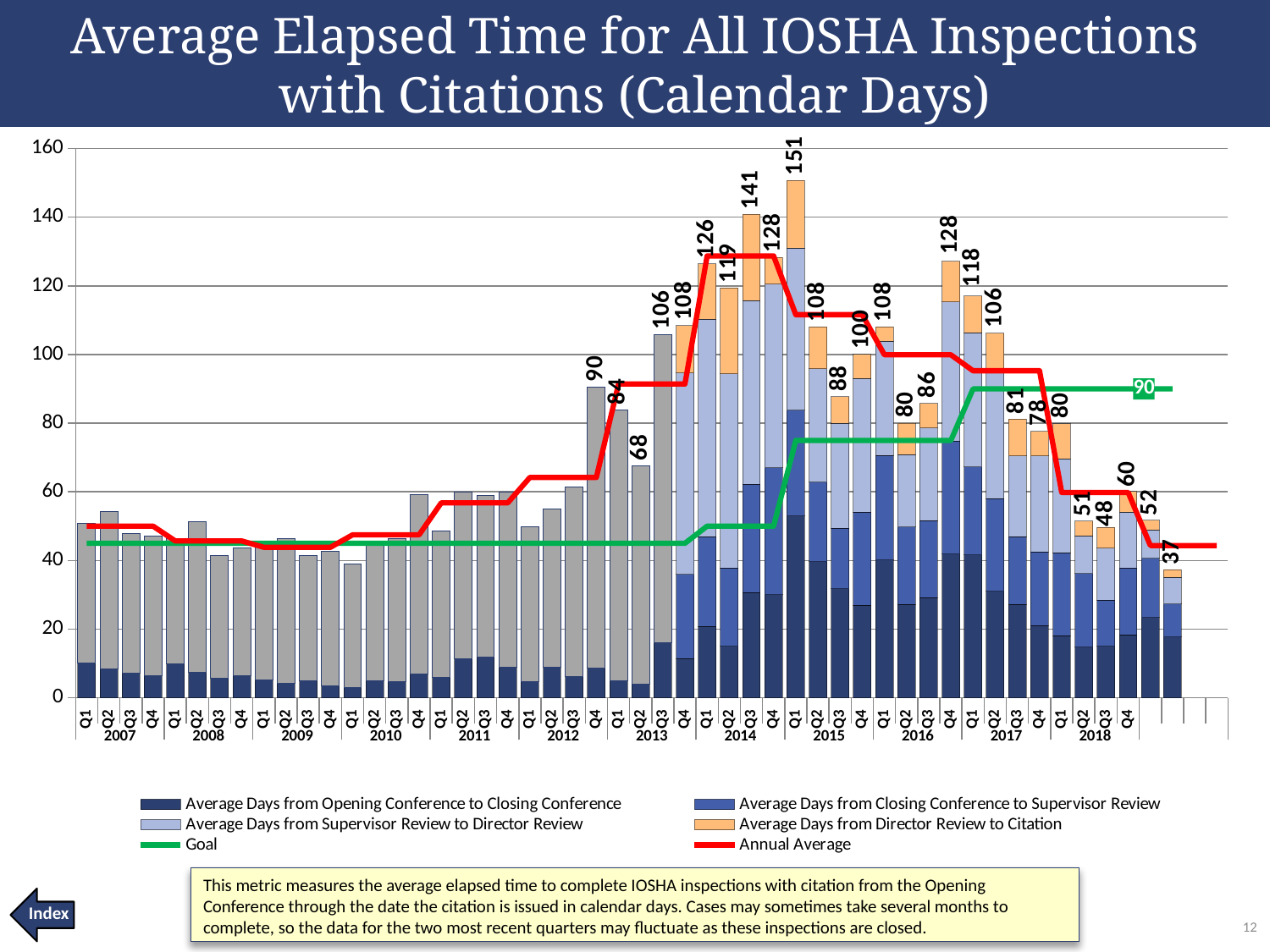
Which quarter has the highest labeled total on the chart? Q1 2015 What kind of chart is used to show the quarterly elapsed time? bar chart Is the total bar height for Q1 2009 greater or less than 60? less What is the total average elapsed time labeled for Q1 2015? 151 What is the difference between the labeled values for Q4 2018 and Q3 2018? 12 What value is labeled on the Goal line at the right end of the chart? 90 Do the labeled totals rise or fall from Q2 2013 to Q1 2014? rise What is the difference between the labeled values for Q1 2015 and Q3 2014? 10 What is the labeled value for Q2 2018? 51 Which is larger, the labeled value for Q4 2016 or for Q1 2017? Q4 2016 How many entries does the legend list? 6 What is the labeled value for Q3 2014? 141